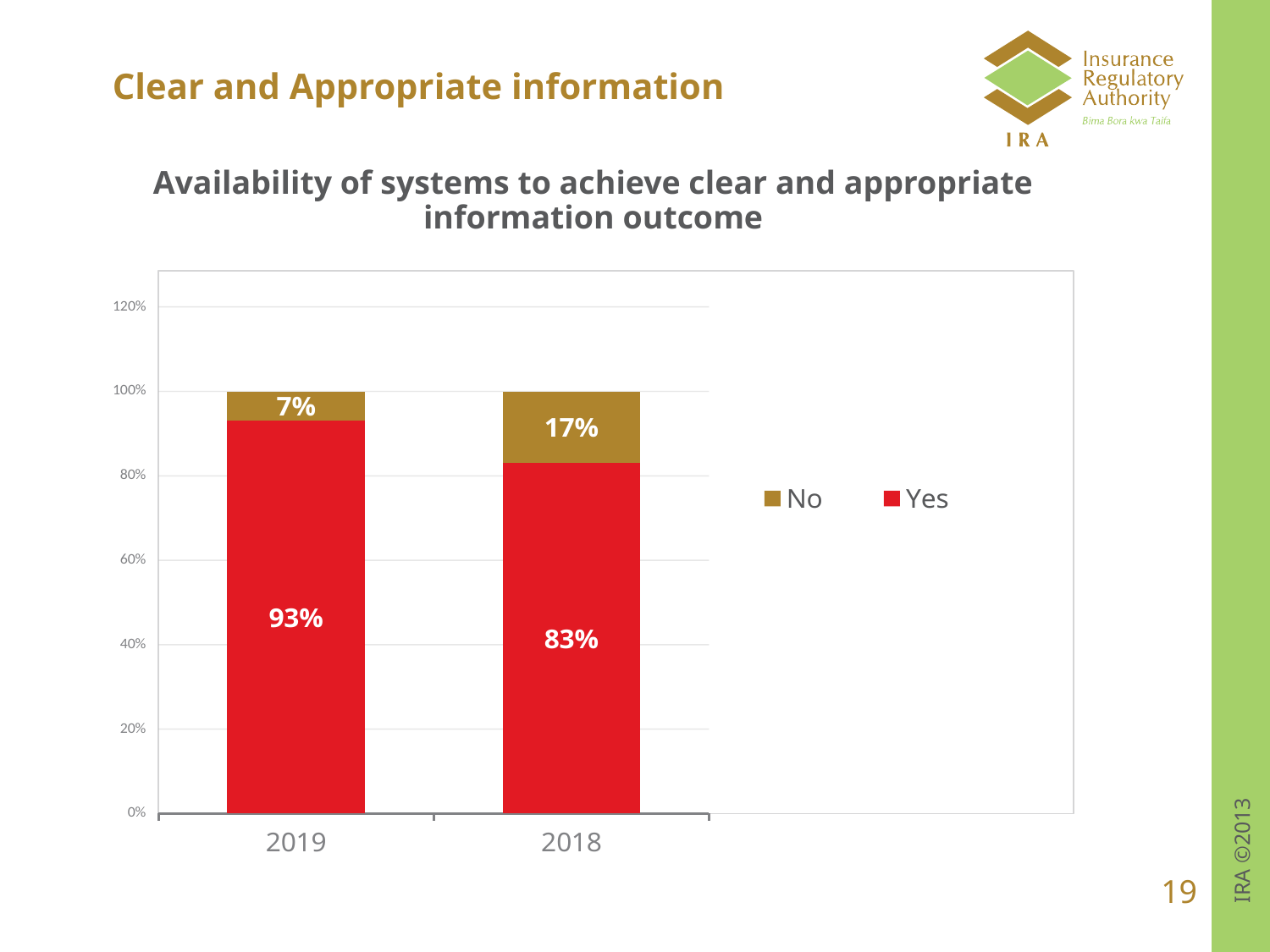
How many series does the legend list? 2 Is the No value for 2018 larger or smaller than the No value for 2019? larger Which year has the higher value for Yes? 2019 Which year has the lower value for No? 2019 What is the value for No in 2019? 7% How many years are shown on the x axis? 2 What is the value for Yes in 2018? 83% What is the value for No in 2018? 17% What is the total of the stacked bar for 2019? 100% What kind of chart is shown? Stacked bar chart What is the value for Yes in 2019? 93% What is the difference between the Yes values for 2019 and 2018? 10%